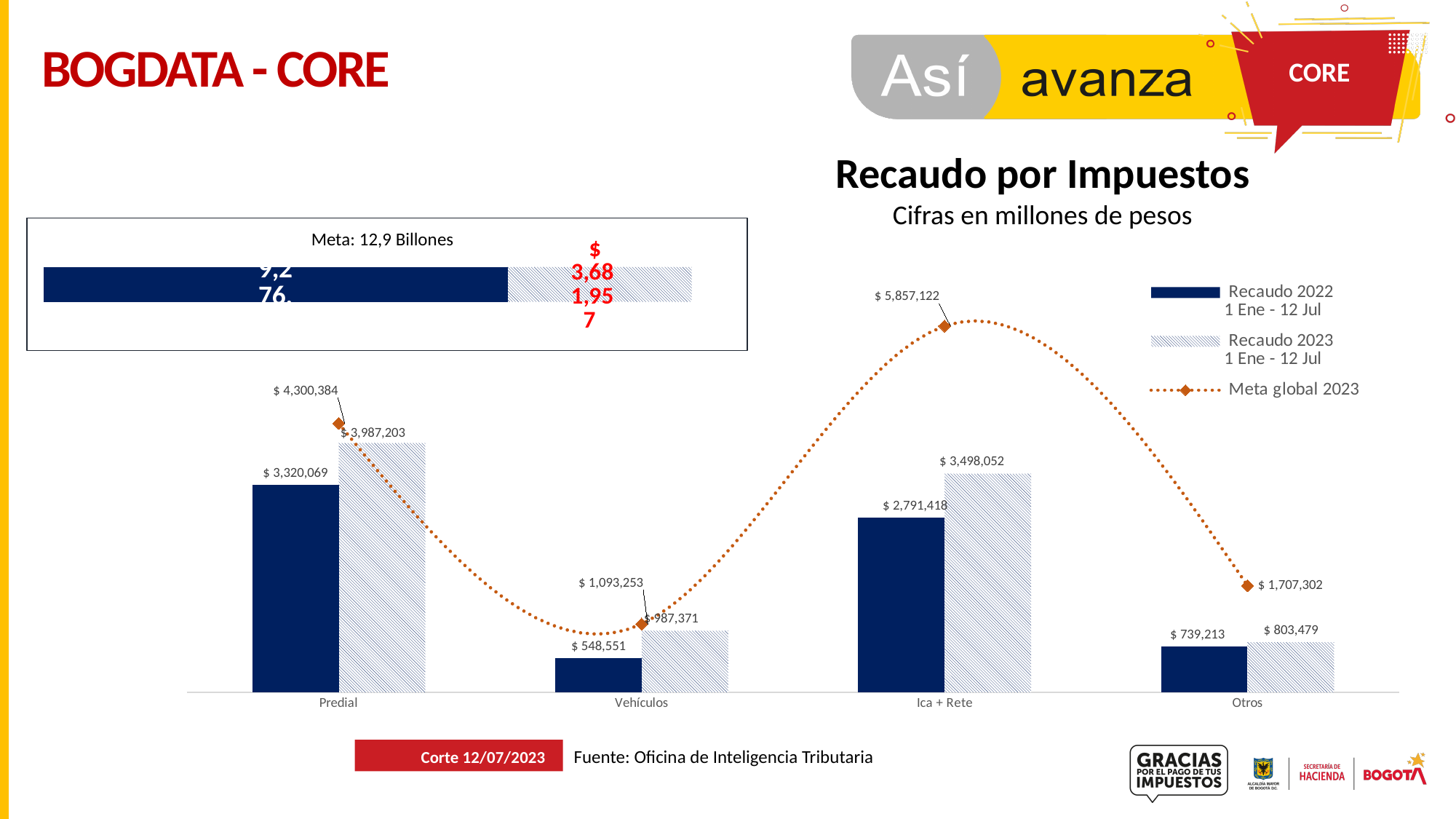
In the Recaudo por Impuestos chart, what is the Recaudo 2023 value for Otros? $ 803,479 In the Recaudo por Impuestos chart, which is larger for Otros: Recaudo 2022 or Recaudo 2023? Recaudo 2023 In the Recaudo por Impuestos chart, what is the difference between the Meta global 2023 and Recaudo 2023 for Ica + Rete? 2,359,070 In the Recaudo por Impuestos chart, what is the Recaudo 2023 value for Ica + Rete? $ 3,498,052 In the Recaudo por Impuestos chart, what is the difference between Recaudo 2023 and Recaudo 2022 for Predial? 667,134 How many series does the legend of the Recaudo por Impuestos chart list? 3 In the Recaudo por Impuestos chart, what is the Recaudo 2022 value for Predial? $ 3,320,069 In the Recaudo por Impuestos chart, what is the Meta global 2023 value for Vehículos? $ 1,093,253 In the Recaudo por Impuestos chart, which category has the highest Meta global 2023 value? Ica + Rete In the Recaudo por Impuestos chart, which category has the lowest Recaudo 2022 value? Vehículos What is the subtitle under the title Recaudo por Impuestos indicating the units of the chart? Cifras en millones de pesos How many categories are shown on the x axis of the Recaudo por Impuestos chart? 4